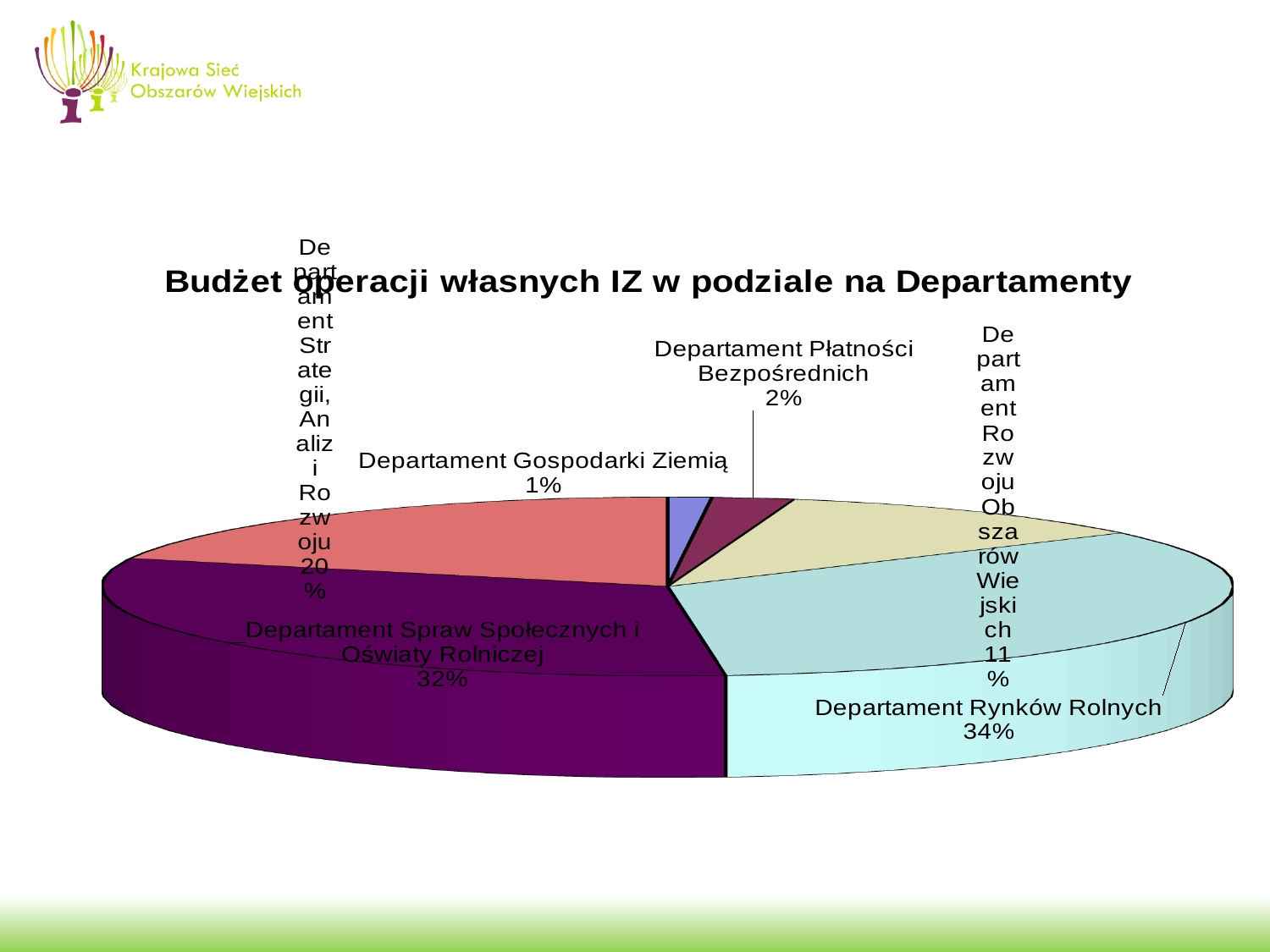
What share of the pie does Departament Strategii, Analiz i Rozwoju have? 20% What share of the pie does Departament Rynków Rolnych have? 34% Which department has the smallest share of the budget? Departament Gospodarki Ziemią Which department has the largest share of the budget? Departament Rynków Rolnych How many slices does the pie chart have? 6 What is the title of the chart? Budżet operacji własnych IZ w podziale na Departamenty What is the difference in percentage points between Departament Rynków Rolnych and Departament Rozwoju Obszarów Wiejskich? 23 percentage points What share of the pie does Departament Spraw Społecznych i Oświaty Rolniczej have? 32% What kind of chart is shown on the slide? pie chart